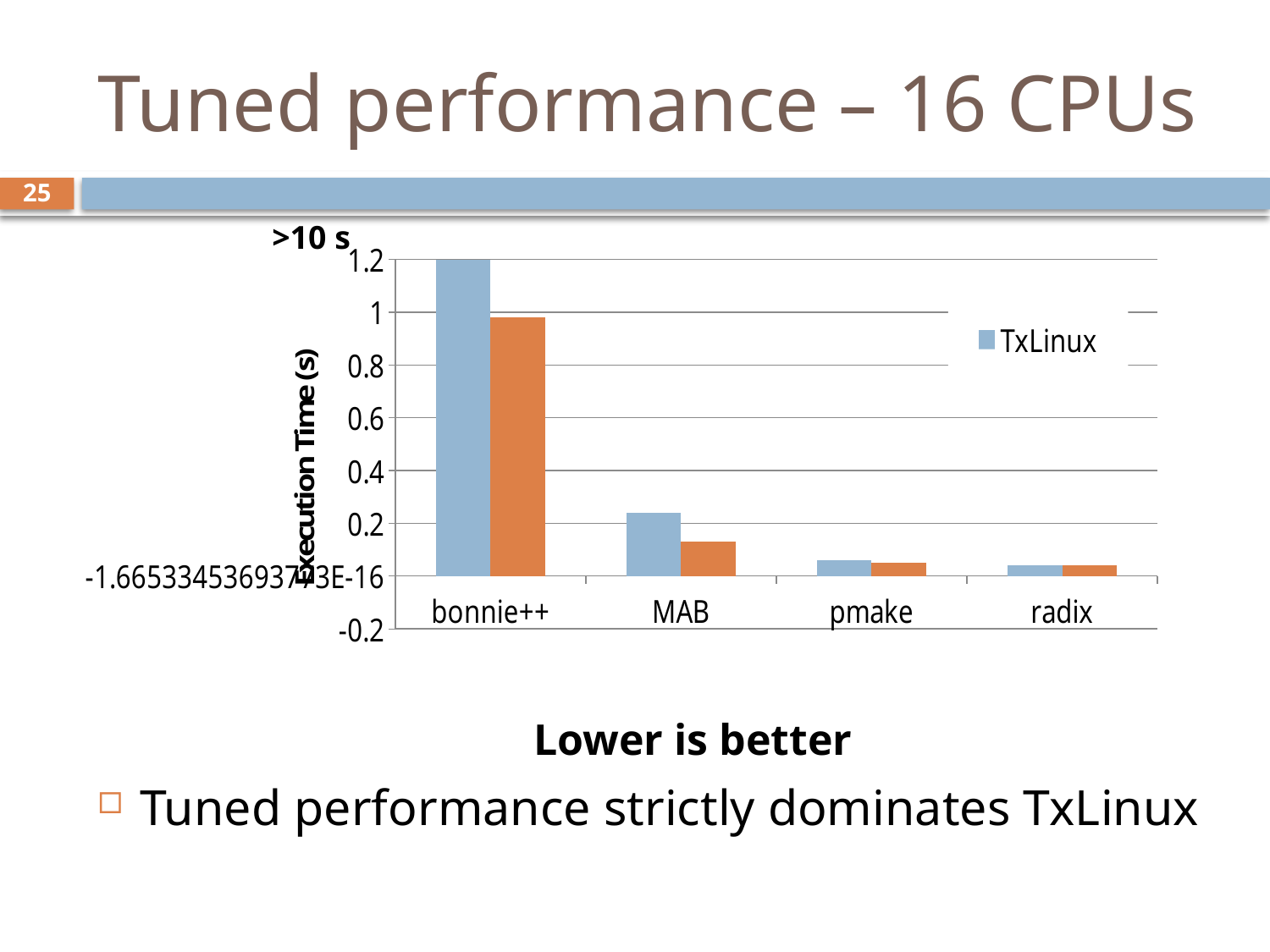
How many categories are shown on the x axis of the chart? 4 Is the TxLinux value for pmake greater or less than 0.2? less Is the TxLinux value for bonnie++ greater or less than 1? greater Which series name appears in the chart's legend? TxLinux Is the TxLinux value for radix greater or less than 0.2? less Which category has the highest TxLinux execution time? bonnie++ What kind of chart is shown on the slide? bar chart For bonnie++, which bar is taller, the TxLinux bar or the orange bar? TxLinux What is the title of the y axis? Execution Time (s) How many series does the chart's legend list? 1